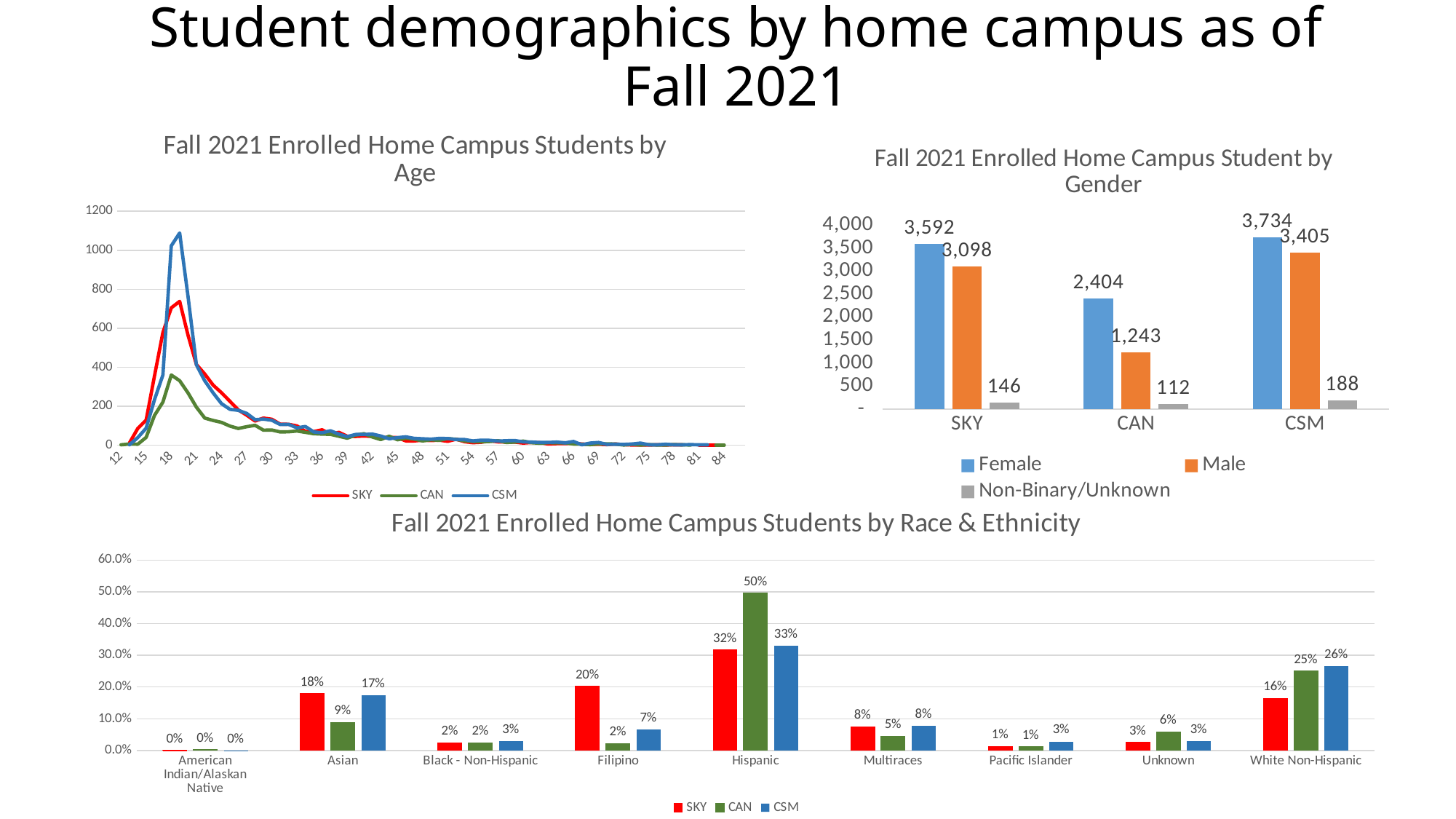
In the 'Fall 2021 Enrolled Home Campus Students by Race & Ethnicity' chart, what is the SKY value for Filipino? 20% In the 'Fall 2021 Enrolled Home Campus Student by Gender' chart, which campus has the lowest number of Non-Binary/Unknown students? CAN What kind of chart is 'Fall 2021 Enrolled Home Campus Students by Age'? Line chart In the 'Fall 2021 Enrolled Home Campus Student by Gender' chart, how many Female students does CSM have? 3,734 In the 'Fall 2021 Enrolled Home Campus Students by Age' chart, is the peak value of the CSM line greater or less than 1000? greater In the 'Fall 2021 Enrolled Home Campus Student by Gender' chart, what is the difference between Female and Male students at SKY? 494 In the 'Fall 2021 Enrolled Home Campus Students by Race & Ethnicity' chart, which category has the highest CSM value? Hispanic In the 'Fall 2021 Enrolled Home Campus Students by Race & Ethnicity' chart, which is larger for Asian: SKY or CAN? SKY In the 'Fall 2021 Enrolled Home Campus Students by Race & Ethnicity' chart, what is the CAN value for Hispanic? 50% In the 'Fall 2021 Enrolled Home Campus Student by Gender' chart, how many series does the legend list? 3 In the 'Fall 2021 Enrolled Home Campus Students by Race & Ethnicity' chart, how many race/ethnicity categories are shown on the x axis? 9 In the 'Fall 2021 Enrolled Home Campus Student by Gender' chart, how many Male students does CAN have? 1,243